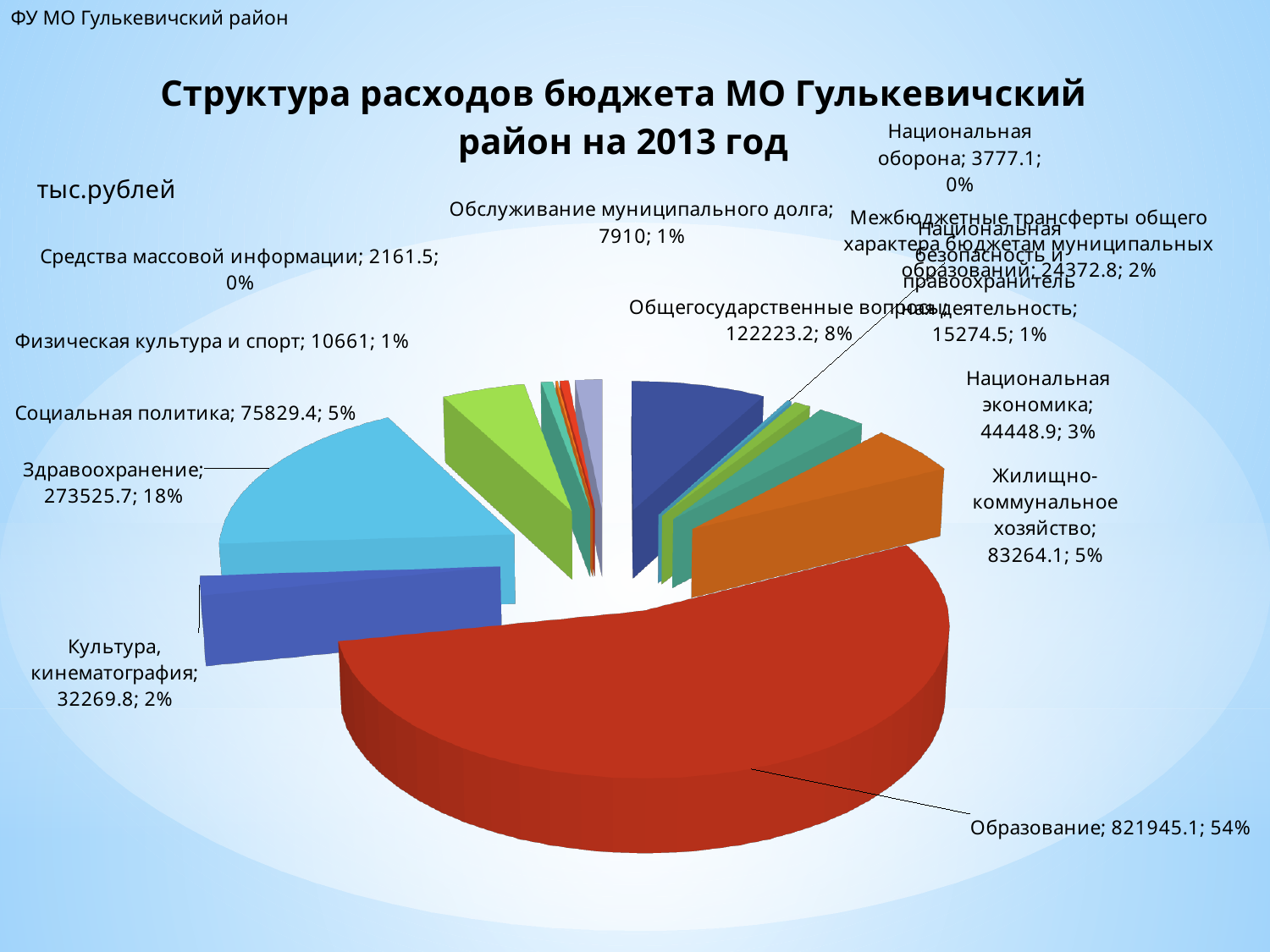
How many categories are shown in the pie chart? 13 What is the value for Здравоохранение? 273525.7 Which category has the smallest value in the pie chart? Средства массовой информации What is the difference between the values for Образование and Здравоохранение? 548419.4 What is the value for Общегосударственные вопросы? 122223.2 Which category has the largest share of the budget expenditure? Образование What share of the pie does Здравоохранение represent? 18% In what units are the values on the chart expressed? тыс.рублей Which is larger: Социальная политика or Национальная экономика? Социальная политика What kind of chart is shown on the slide? pie chart What is the value for Жилищно-коммунальное хозяйство? 83264.1 What share of the pie does Образование represent? 54%